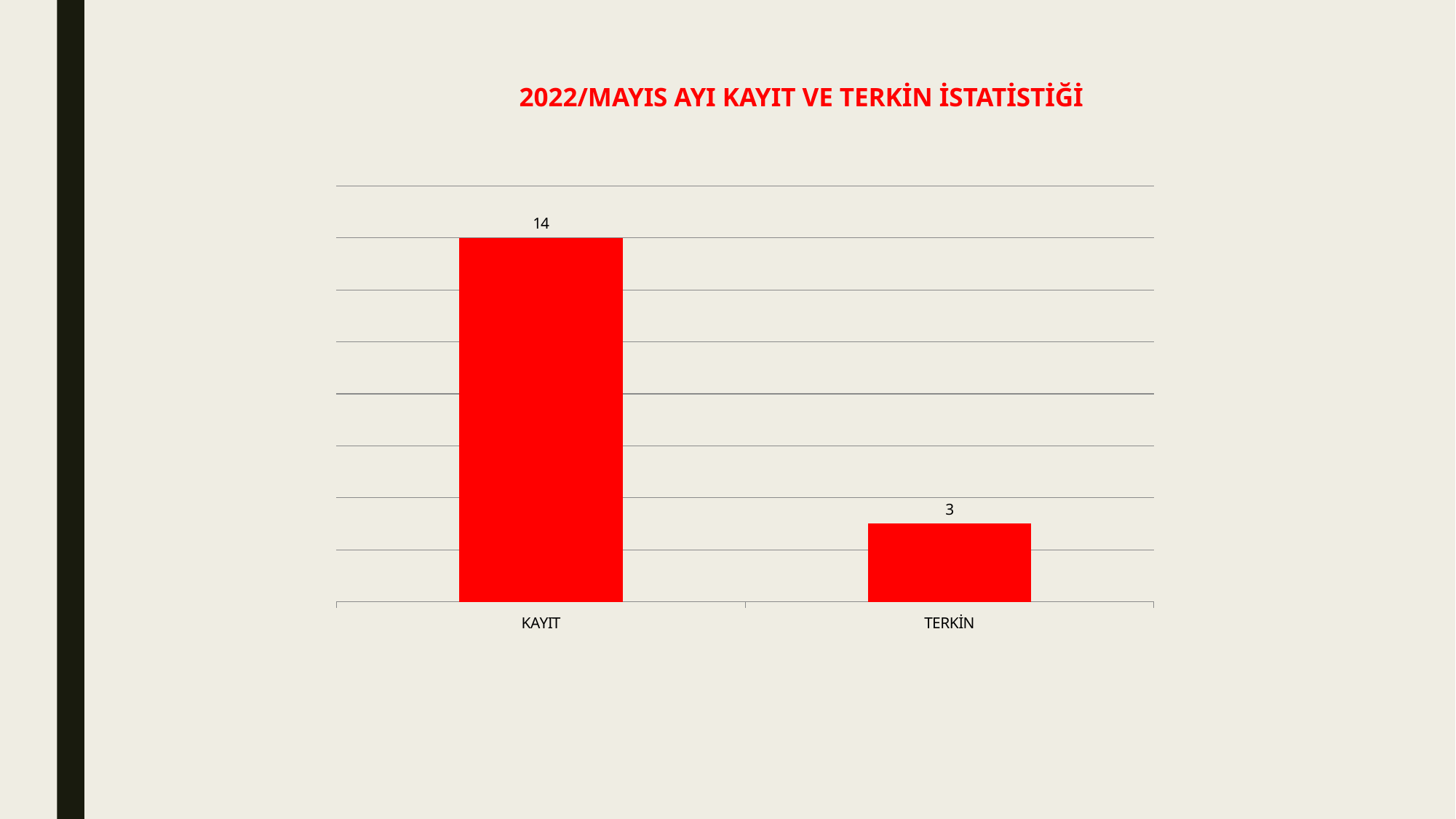
What is the value for KAYIT? 14 How many categories are shown on the x axis? 2 What is the value for TERKİN? 3 Which category has the lowest value? TERKİN Which is larger, the value for KAYIT or the value for TERKİN? KAYIT Which category has the highest value? KAYIT What is the title of the chart? 2022/MAYIS AYI KAYIT VE TERKİN İSTATİSTİĞİ What colour are the bars in the chart? red What kind of chart is shown on the slide? bar chart What is the difference between the values for KAYIT and TERKİN? 11 Do the values rise or fall from KAYIT to TERKİN? fall